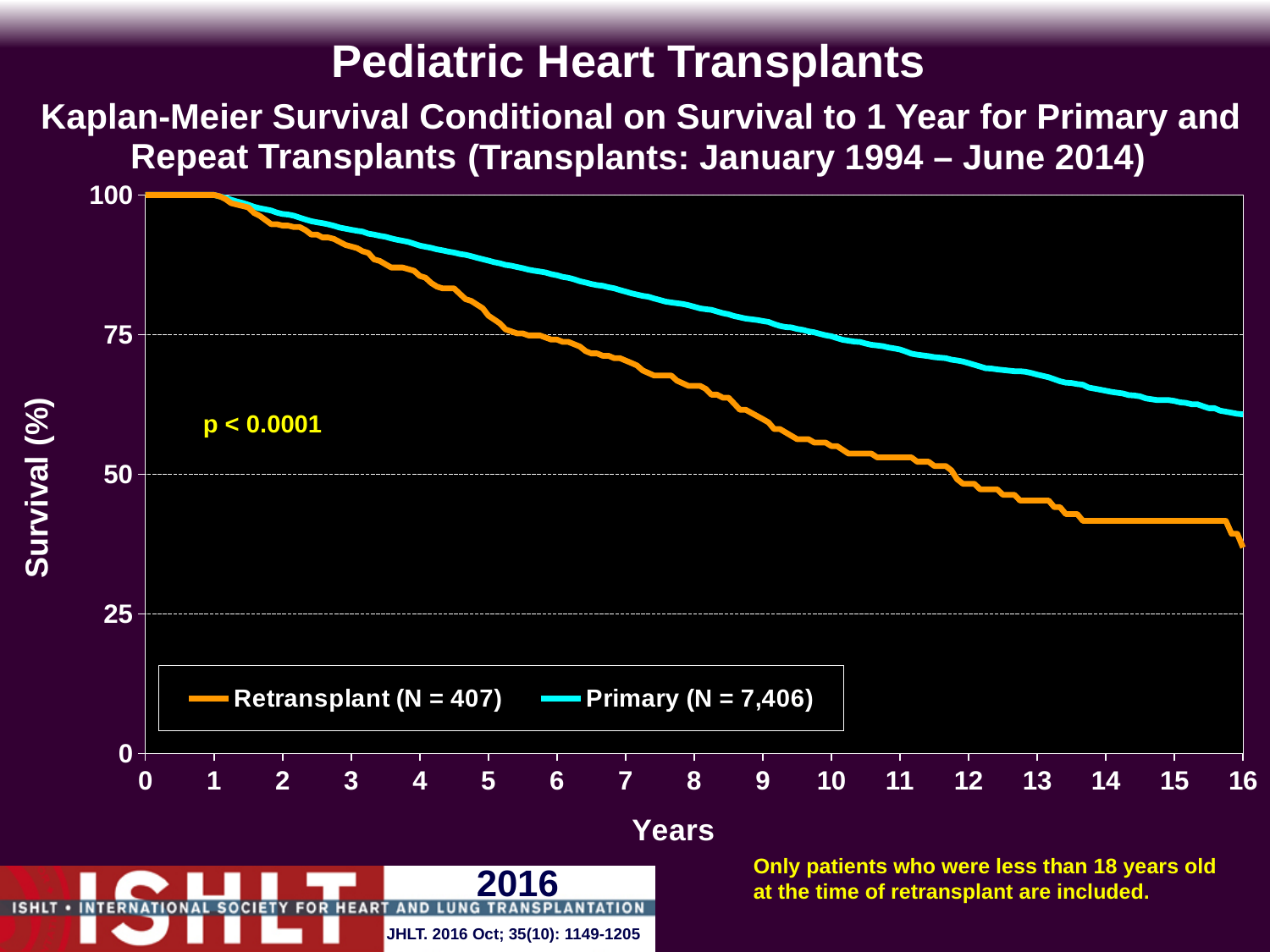
Is the survival value for the Primary group at 8 years greater or less than 75? greater What kind of chart is shown on the slide? Line chart At 10 years, which group has the higher survival, Retransplant or Primary? Primary What is the N for the Primary group shown in the legend? 7,406 What are the two series named in the legend? Retransplant (N = 407) and Primary (N = 7,406) How many series does the legend list? 2 Do the survival curves rise or fall as years increase? Fall Is the survival value for the Retransplant group at 16 years greater or less than 50? less What is the N for the Retransplant group shown in the legend? 407 What p-value is printed on the chart? p < 0.0001 Is the survival value for the Primary group at 16 years greater or less than 50? greater